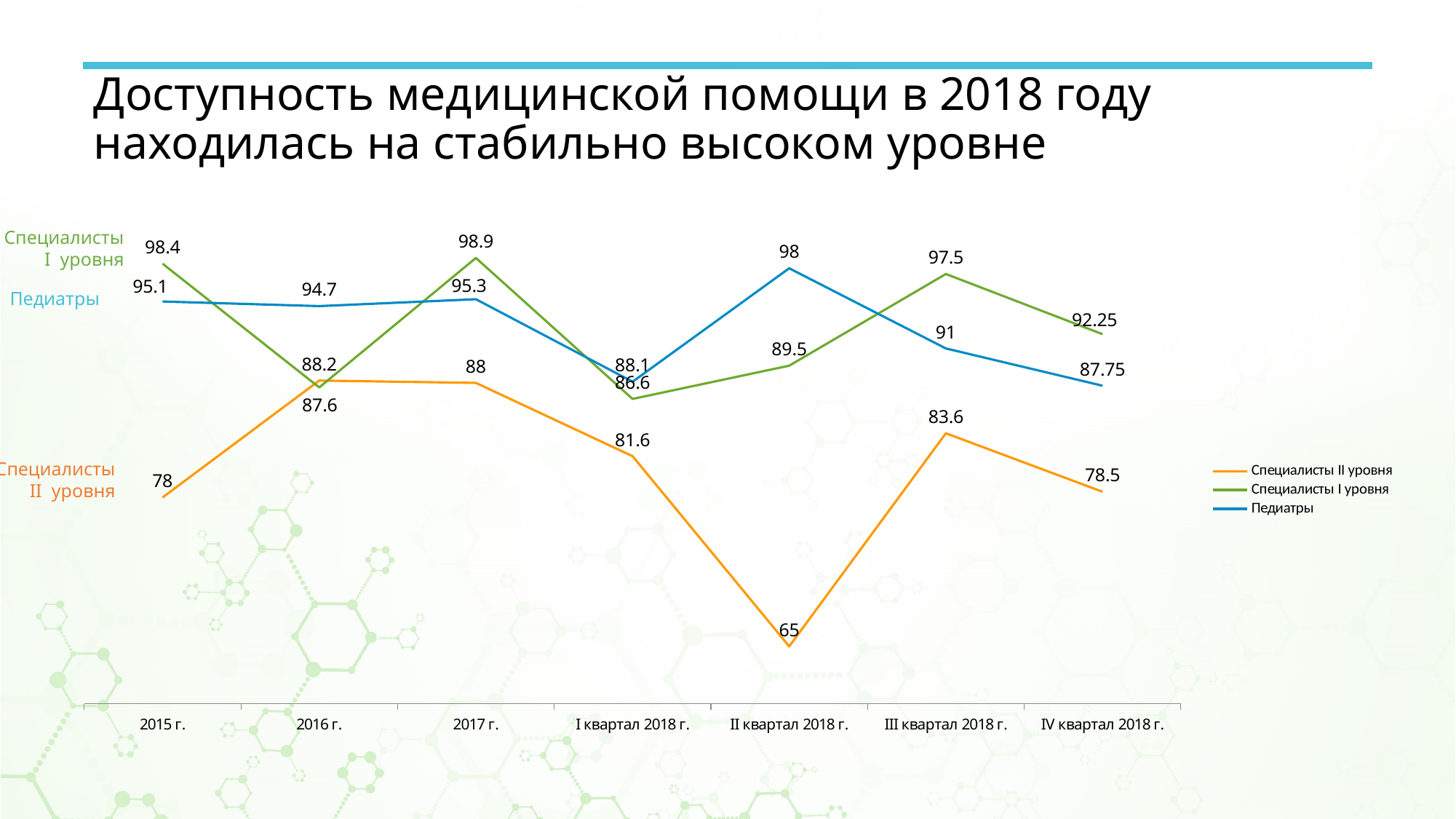
What is the difference between the Педиатры values in II квартал 2018 г. and IV квартал 2018 г.? 10.25 In which category does Специалисты I уровня reach its highest value? 2017 г. What is the value for Педиатры in II квартал 2018 г.? 98 Which is larger in III квартал 2018 г.: Специалисты I уровня or Педиатры? Специалисты I уровня What is the value for Специалисты I уровня in IV квартал 2018 г.? 92.25 In which category does Специалисты II уровня have its lowest value? II квартал 2018 г. How many series does the legend list? 3 How many categories are shown on the x axis? 7 What type of chart is shown on the slide? line chart Does the value for Специалисты II уровня rise or fall from III квартал 2018 г. to IV квартал 2018 г.? fall Which colour is used for the Педиатры series? blue What is the value for Специалисты II уровня in II квартал 2018 г.? 65